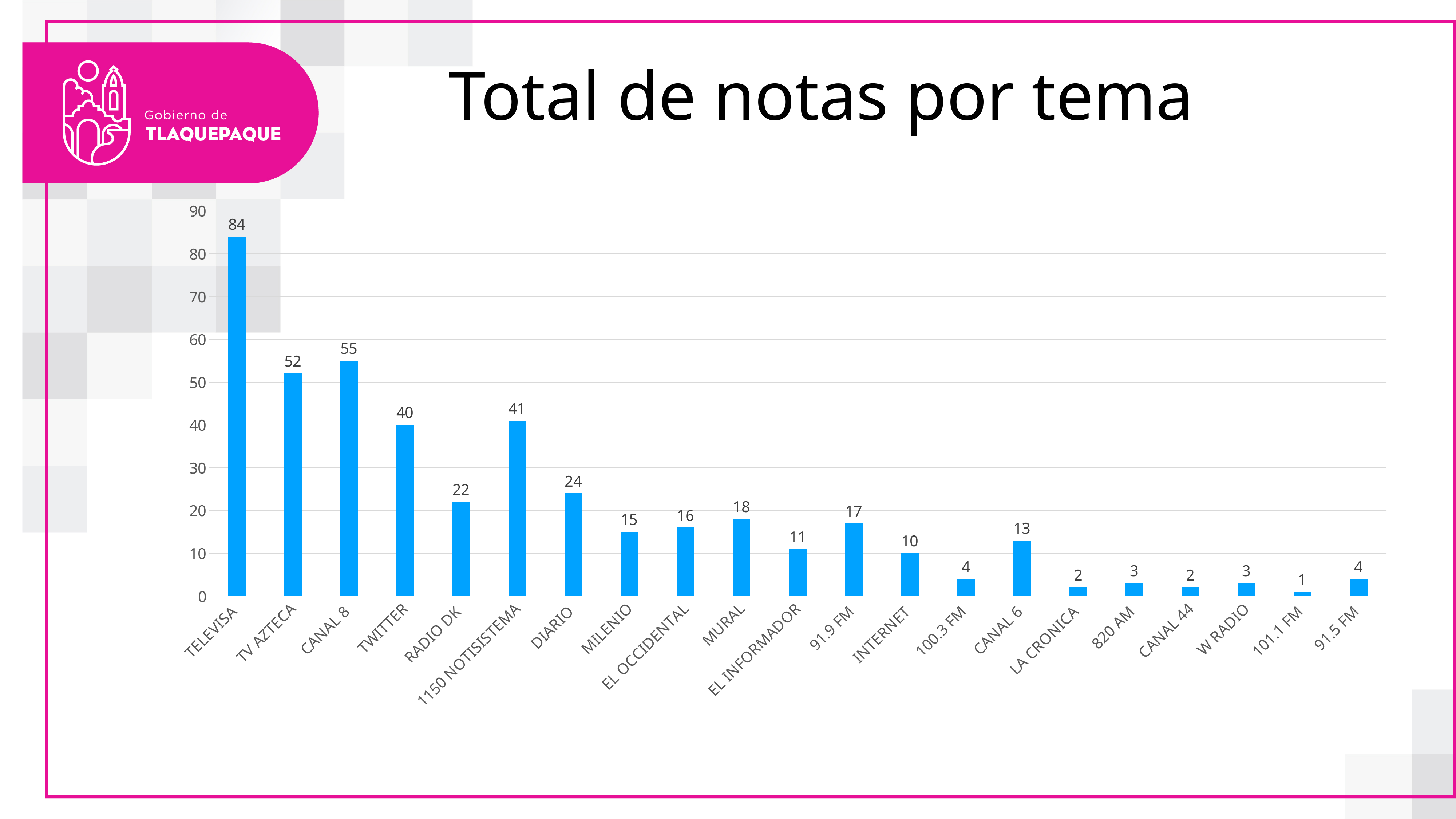
Which category has the lowest value? 101.1 FM Which is larger, the value for TV AZTECA or the value for CANAL 8? CANAL 8 What is the value for CANAL 6? 13 What is the difference between the values for RADIO DK and DIARIO? 2 What is the difference between the values for TELEVISA and CANAL 8? 29 How many categories are shown on the x axis? 21 What is the value for 1150 NOTISISTEMA? 41 What is the value for EL INFORMADOR? 11 What is the value for TELEVISA? 84 What is the title of the chart? Total de notas por tema Which category has the highest value? TELEVISA What kind of chart is shown on the slide? Bar chart